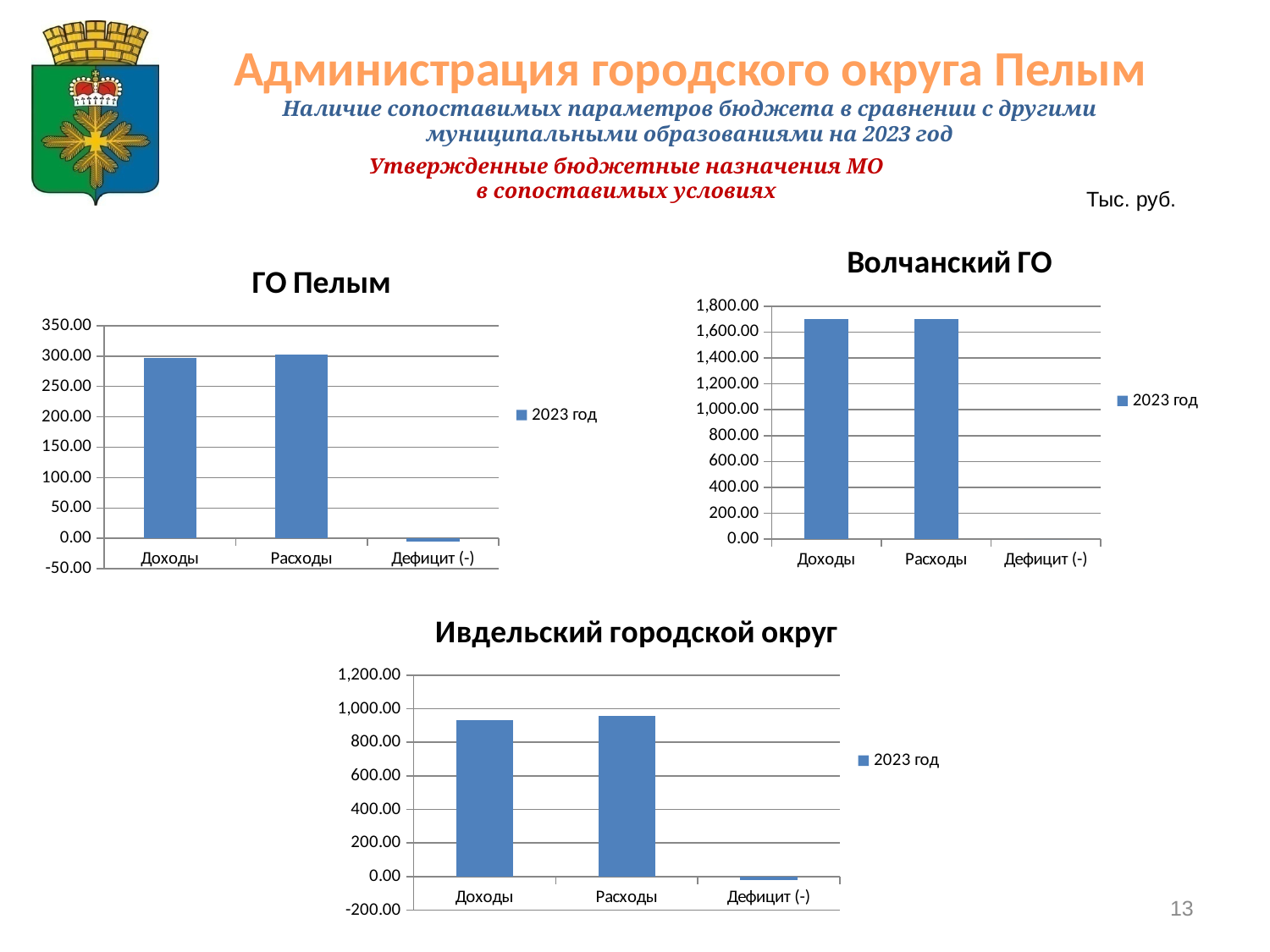
What kind of chart is the 'ГО Пелым' chart? bar chart In the 'Ивдельский городской округ' chart, which category has the lowest value? Дефицит (-) In the 'ГО Пелым' chart, is the value for Доходы greater or less than 250.00? greater In the 'Ивдельский городской округ' chart, is the value for Расходы greater or less than 1,000.00? less In the 'Волчанский ГО' chart, is the value for Расходы greater or less than 1,800.00? less What series name appears in the legend of the 'Волчанский ГО' chart? 2023 год How many categories are shown on the x axis of the 'Волчанский ГО' chart? 3 In the 'ГО Пелым' chart, which category has the lowest value? Дефицит (-) How many series does the legend of the 'Ивдельский городской округ' chart list? 1